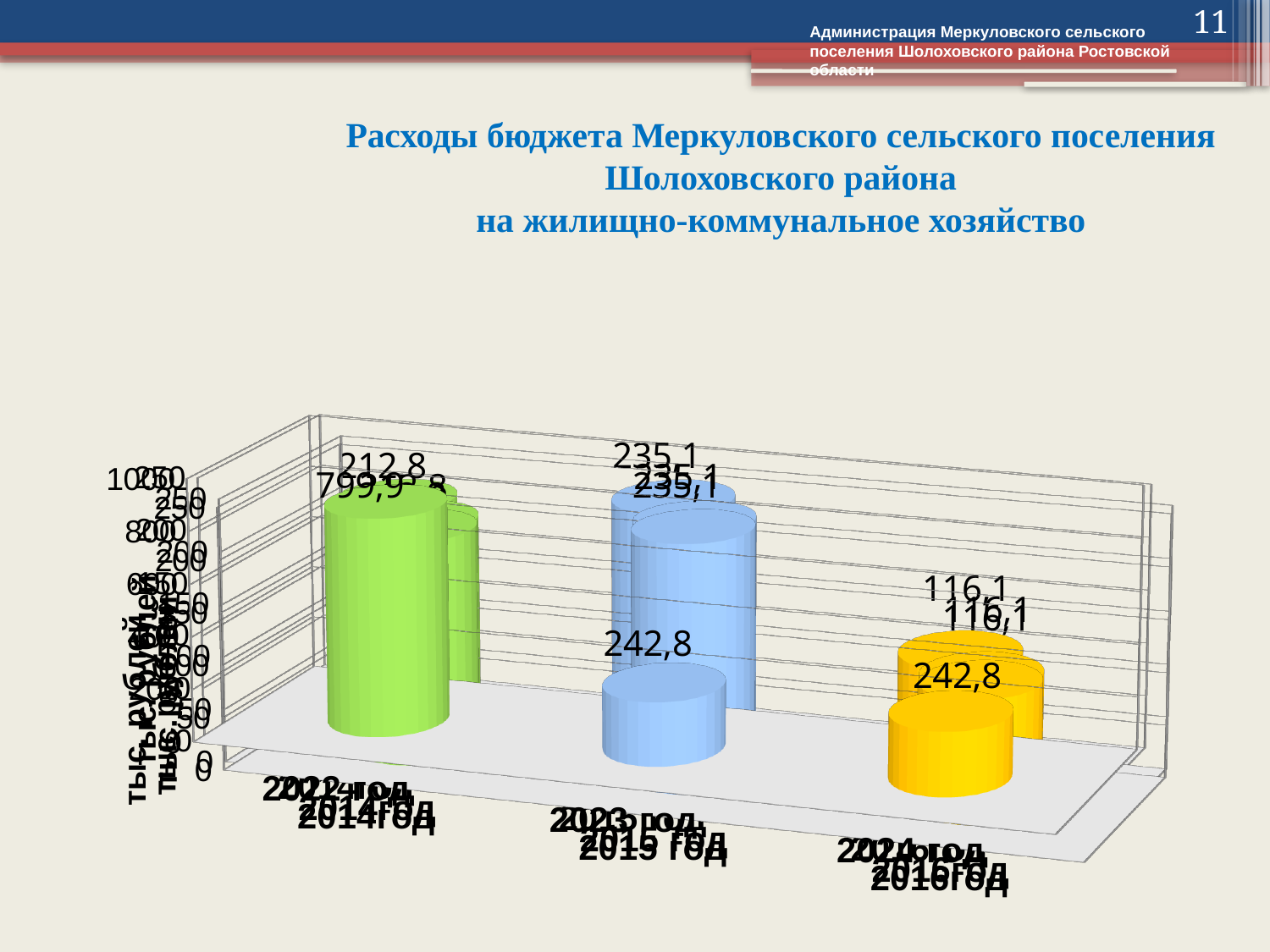
What data label is printed on the front yellow bar in the rightmost group of the chart? 242,8 What data label is printed on the front blue bar in the middle group of the chart? 242,8 What data label is printed on the tall blue bar at the back of the middle group of the chart? 235,1 What kind of chart is shown on the slide? bar chart What data label is printed on the yellow bar at the back of the rightmost group of the chart? 116,1 How many differently coloured bar groups are shown along the x axis of the chart? 3 What is the title of the chart on the slide? Расходы бюджета Меркуловского сельского поселения Шолоховского района на жилищно-коммунальное хозяйство What colour are the bars in the leftmost group of the chart? green